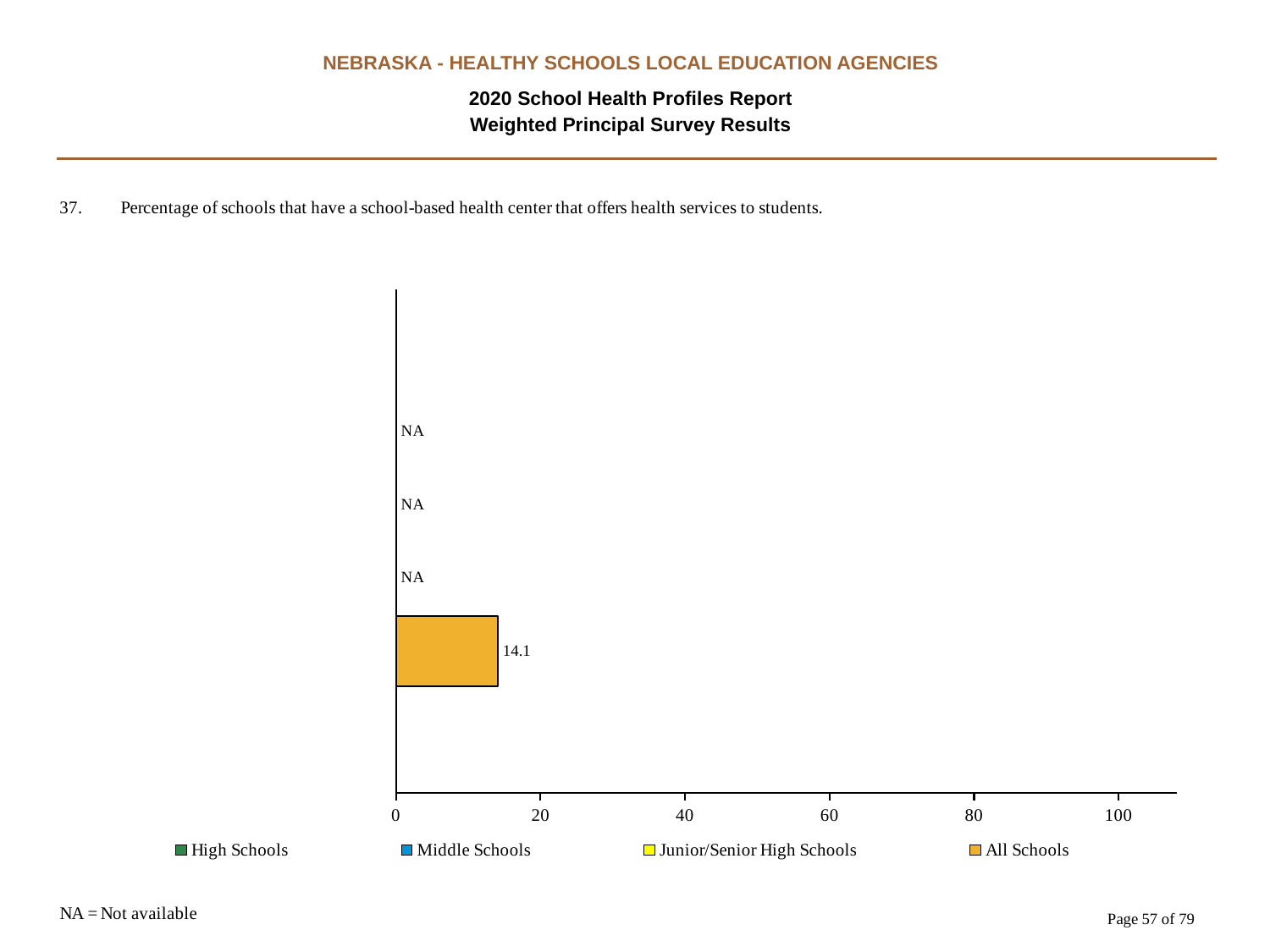
Which series is the only one with a plotted bar? All Schools How many series does the legend list? 4 Is the value for All Schools greater or less than 20? less How many series have a numeric value rather than NA? 1 What is shown for Junior/Senior High Schools? NA What is the highest value shown on the x axis? 100 What is the value for All Schools? 14.1 What is shown for High Schools? NA What kind of chart is this? Bar chart What is shown for Middle Schools? NA